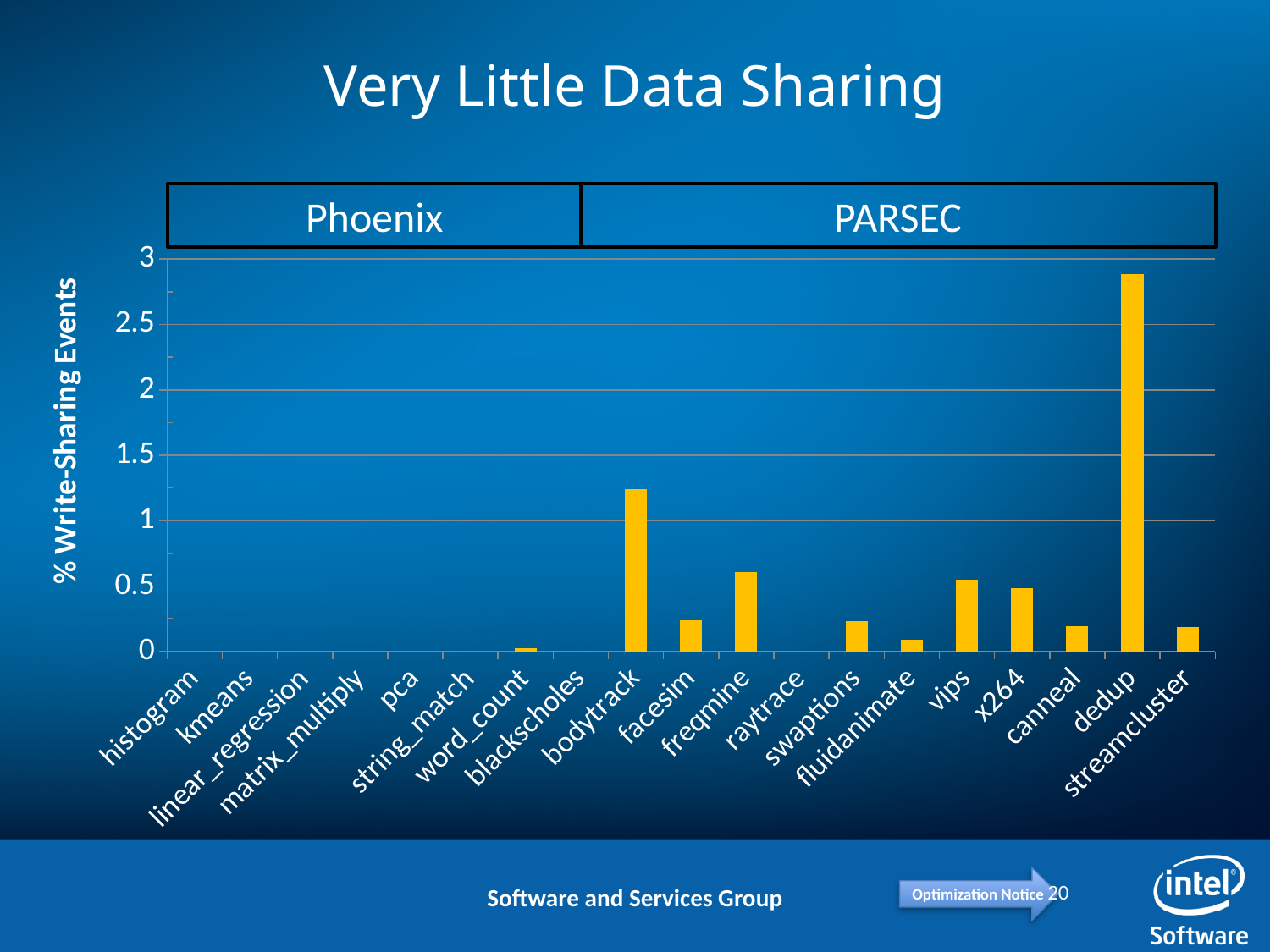
Is the value for dedup greater or less than 2.5? greater Is the value for facesim greater or less than 0.5? less How many benchmarks (categories) are plotted on the x axis? 19 Which benchmark has the highest % Write-Sharing Events? dedup What are the two benchmark suite groups labelled above the chart? Phoenix and PARSEC Is the value for freqmine greater or less than 0.5? greater Which has a larger % Write-Sharing Events, bodytrack or freqmine? bodytrack What kind of chart is shown on the slide? bar chart Which has a larger % Write-Sharing Events, dedup or bodytrack? dedup What is the title of the chart? Very Little Data Sharing